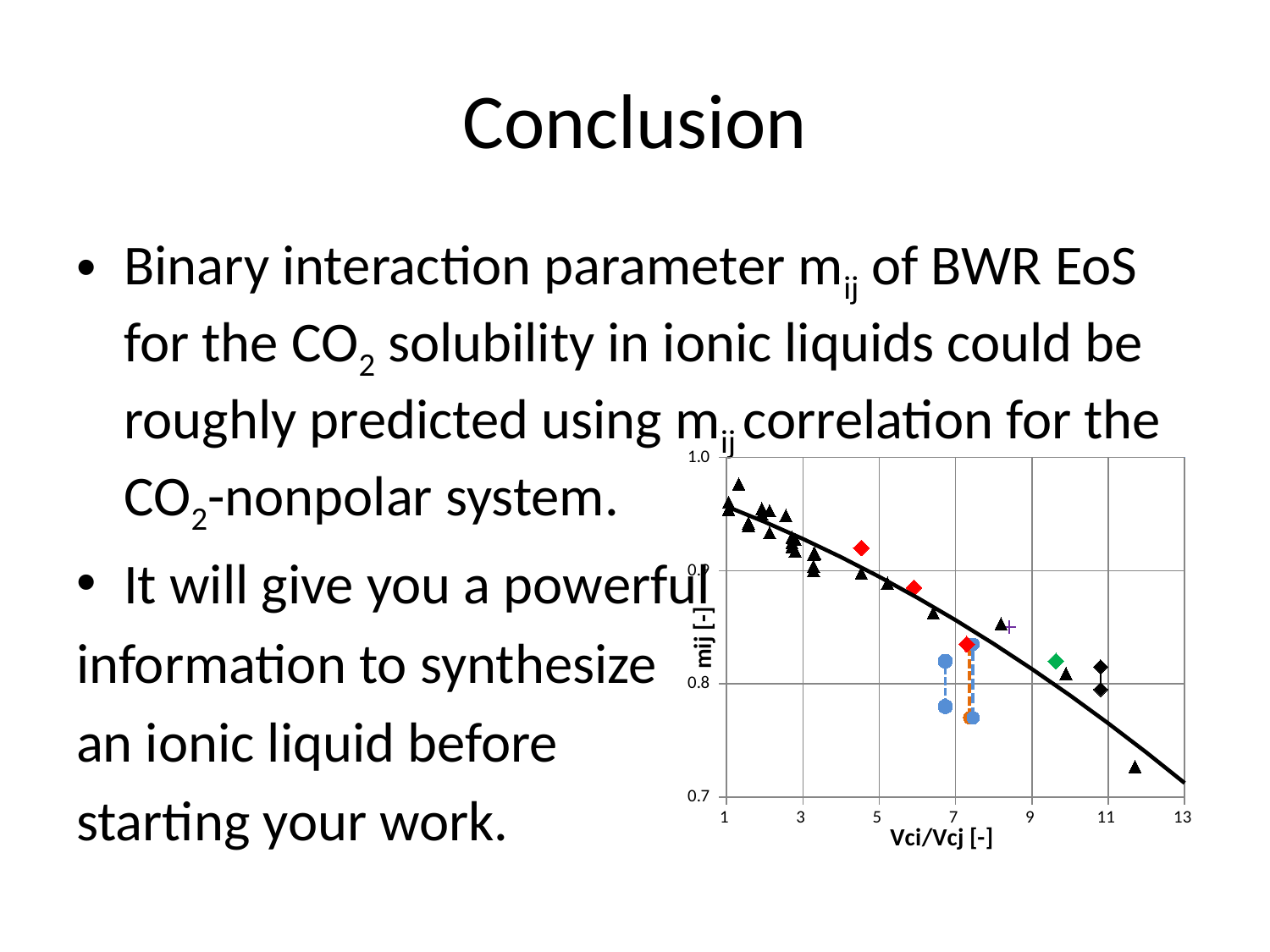
Do the plotted mij values generally rise or fall as Vci/Vcj increases? fall What is the lowest value shown on the y axis of the chart? 0.7 Is the mij value of the red diamond near Vci/Vcj = 4.5 greater or less than 0.9? greater Which has the larger mij value: the red diamond near Vci/Vcj = 4.5 or the red diamond near Vci/Vcj = 7.3? the red diamond near Vci/Vcj = 4.5 What kind of chart is shown on the slide? scatter chart Is the mij value of the green diamond near Vci/Vcj = 9.6 greater or less than 0.8? greater What is the label of the x axis of the chart? Vci/Vcj [-] Is the mij value of the black triangle near Vci/Vcj = 1.3 greater or less than 0.9? greater What is the label of the y axis of the chart? mij [-]